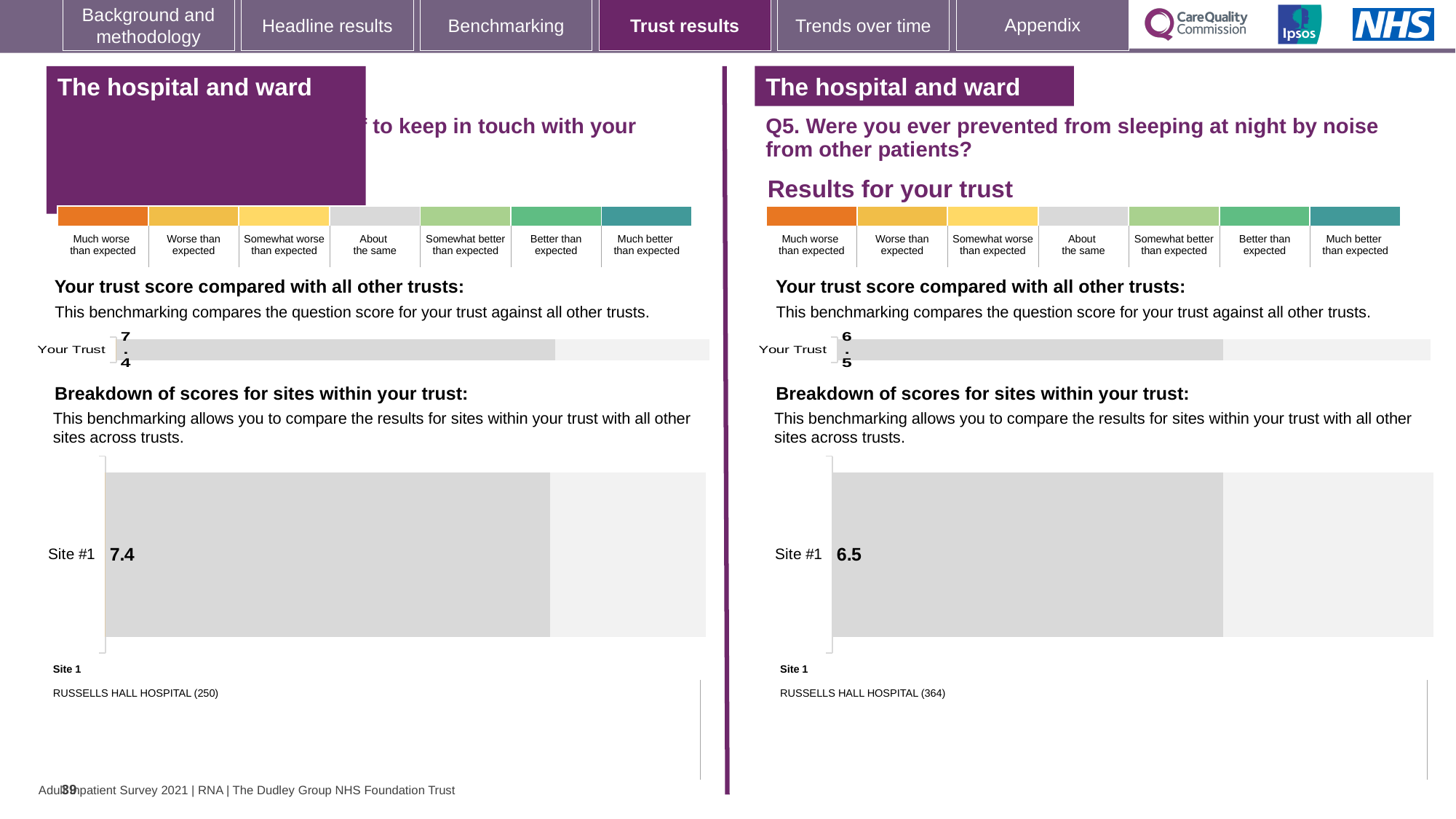
On the right-hand chart for Q5 (prevented from sleeping at night by noise from other patients), what is the score shown for Your Trust? 6.5 On the right-hand panel for Q5, is the Site #1 score the same as the Your Trust score? Yes, both are 6.5 On the left-hand panel, which hospital is listed as Site 1? RUSSELLS HALL HOSPITAL (250) How many sites are shown in the 'Breakdown of scores for sites within your trust' chart on the right-hand panel for Q5? 1 On the right-hand chart for Q5, what is the score shown for Site #1? 6.5 On the left-hand panel's 'Breakdown of scores for sites within your trust' chart, what is the score shown for Site #1? 7.4 What kind of chart is used to show the Site #1 score on the right-hand panel for Q5? Bar chart On the right-hand panel for Q5, which hospital is listed as Site 1? RUSSELLS HALL HOSPITAL (364) On the left-hand panel's 'Your trust score compared with all other trusts' chart, what is the score shown for Your Trust? 7.4 Which is larger: the Your Trust score on the left-hand panel or the Your Trust score on the right-hand panel for Q5? Left-hand panel (7.4) What is the difference between the Site #1 score on the left-hand panel (7.4) and the Site #1 score on the right-hand panel for Q5 (6.5)? 0.9